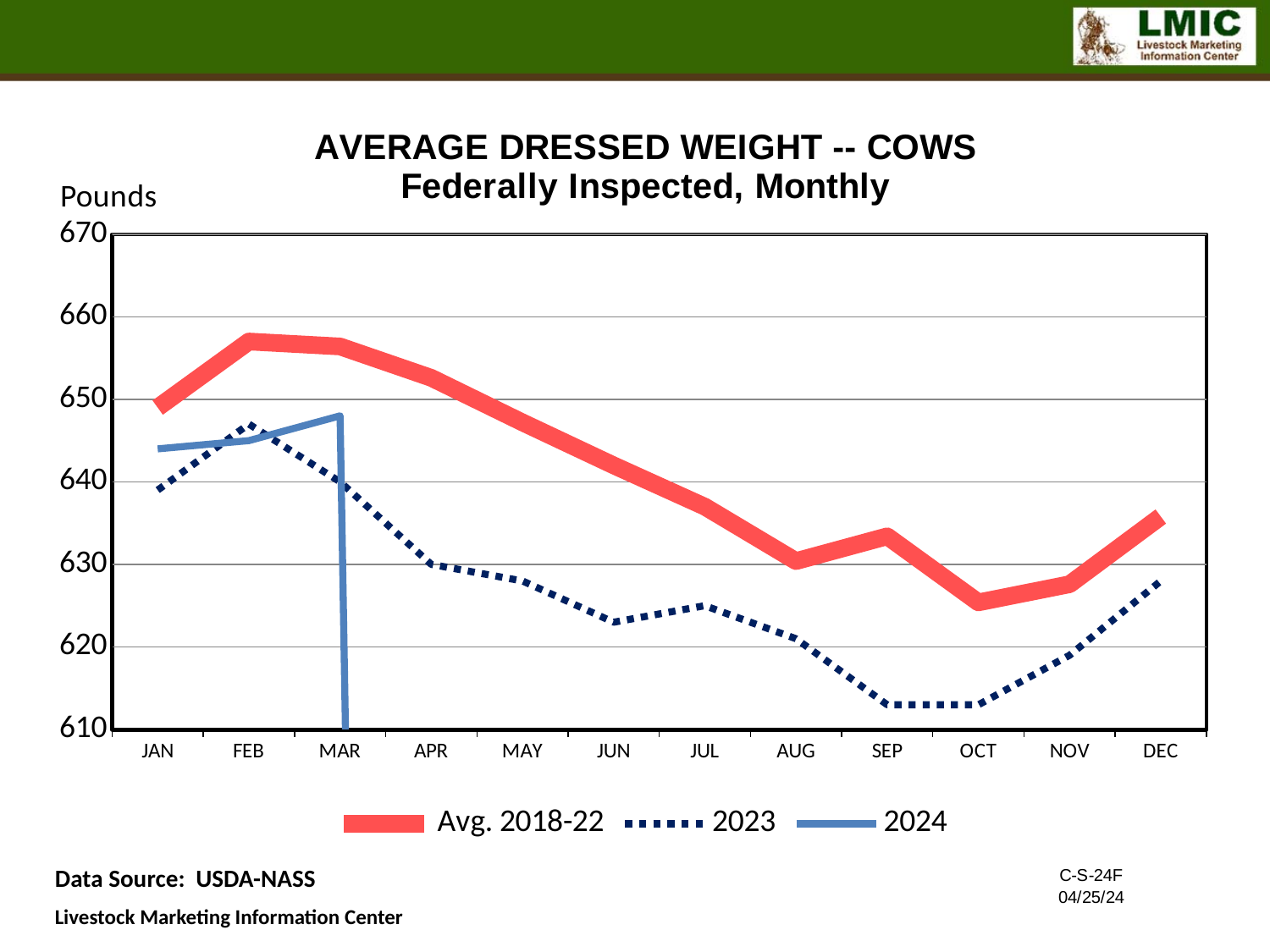
Is the Avg. 2018-22 value for OCT greater or less than 630? less Is the 2023 value for SEP greater or less than 620? less Is the Avg. 2018-22 value for JAN greater or less than 640? greater How many series does the legend list? 3 In which month is the Avg. 2018-22 series at its lowest? OCT In which month is the 2023 series at its highest? FEB How many months are shown along the x axis? 12 What kind of chart is shown on the slide? line chart Does the Avg. 2018-22 series rise or fall from FEB to OCT? fall What unit is shown on the y axis label? Pounds In JUN, which series is higher: Avg. 2018-22 or 2023? Avg. 2018-22